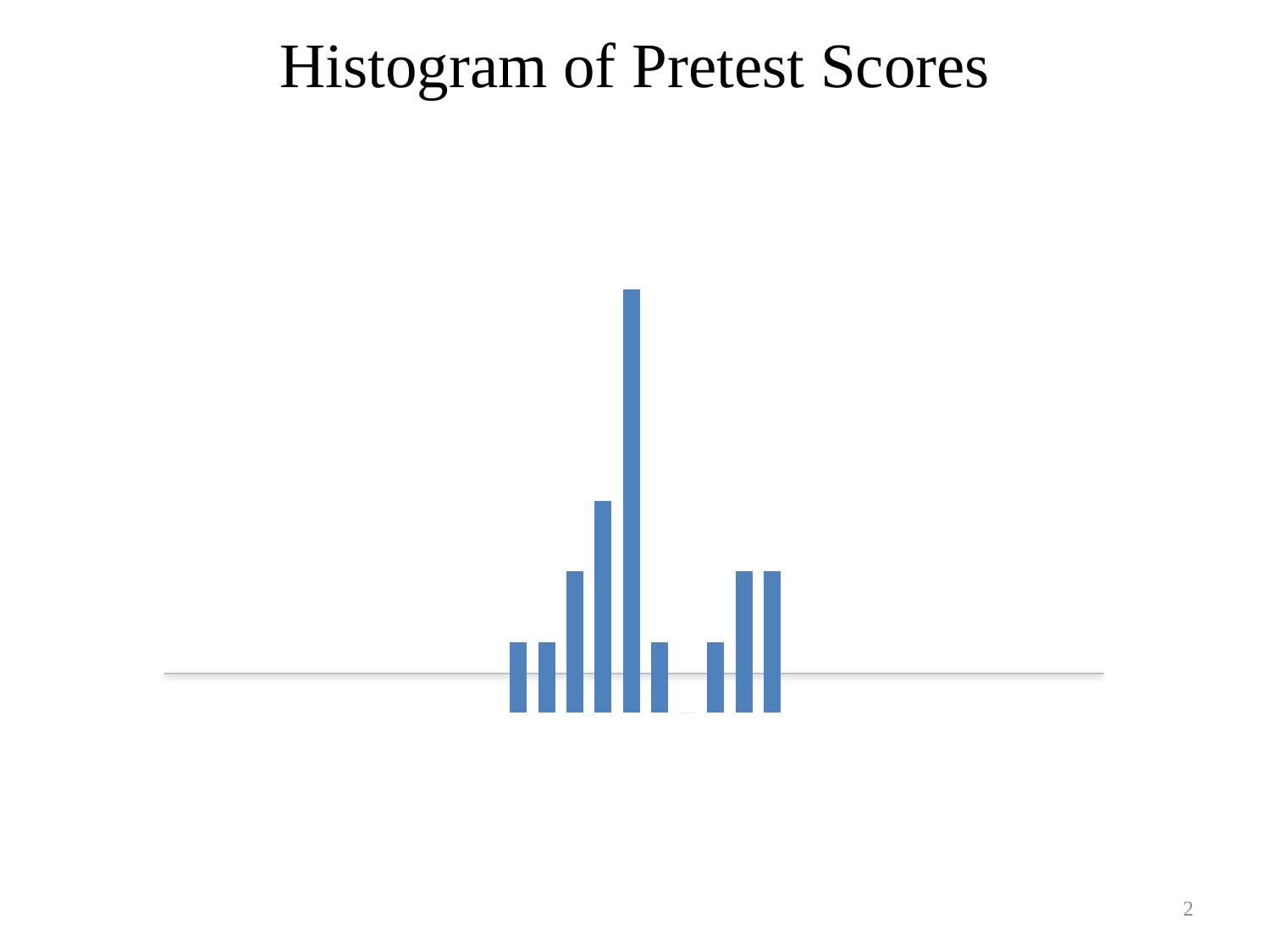
What kind of chart is shown on the slide? bar chart Which bar in the chart is the tallest? the fifth bar from the left What colour are the bars in the chart? blue Is the first bar from the left taller or shorter than the third bar from the left? shorter What is the title of the chart on the slide? Histogram of Pretest Scores Are the two rightmost bars in the chart the same height? yes Is the fifth bar from the left taller or shorter than the fourth bar from the left? taller